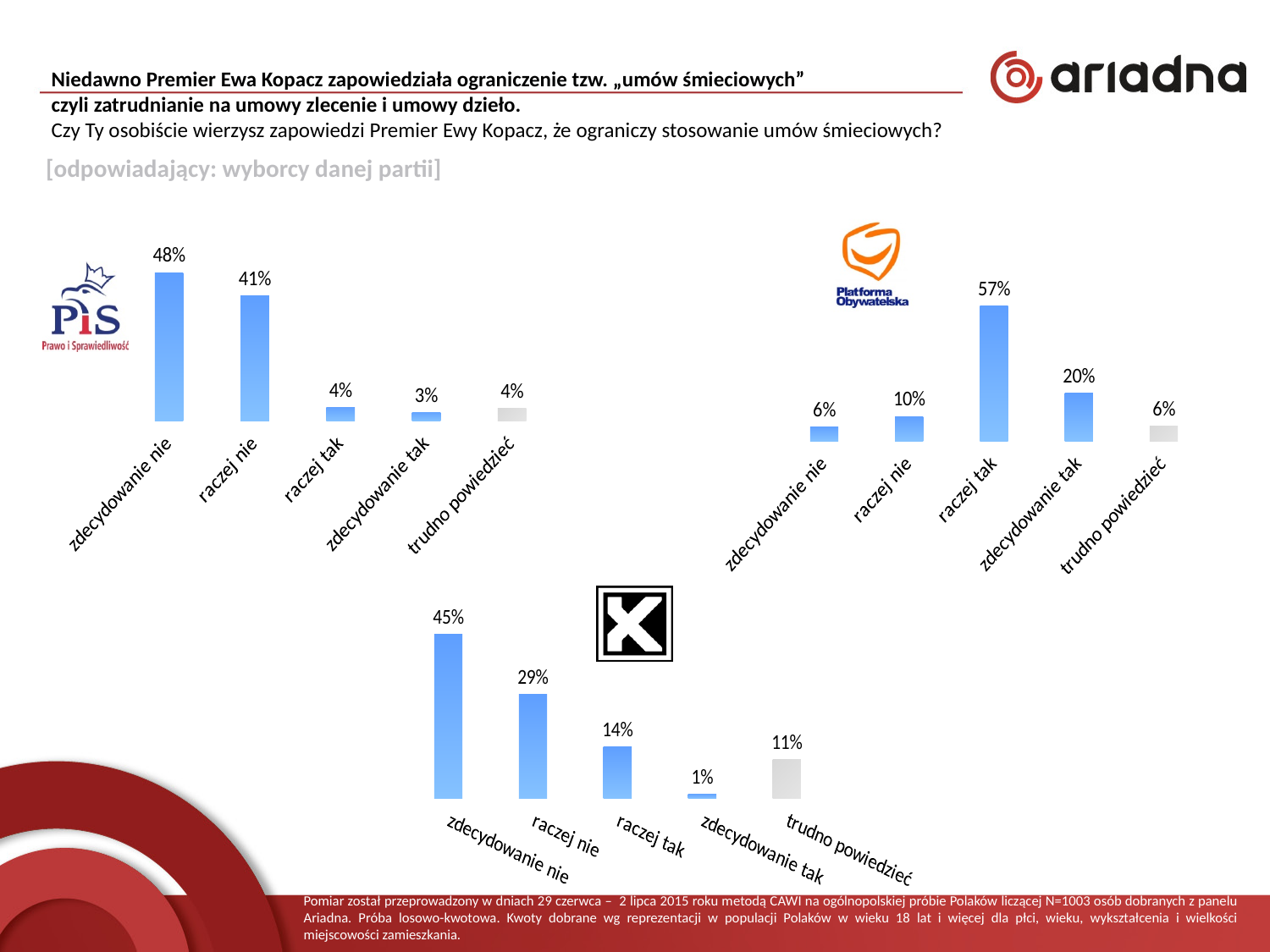
In the Platforma Obywatelska chart (top right), what is the difference between "raczej tak" and "zdecydowanie tak"? 37% In the bottom chart, what percentage answered "trudno powiedzieć"? 11% What type of chart is used for the Platforma Obywatelska data (top right)? bar chart In the bottom chart, which answer has the lowest value? zdecydowanie tak How many answer categories does the PiS chart (top left) show? 5 In the Platforma Obywatelska chart (top right), what percentage answered "raczej tak"? 57% In the Platforma Obywatelska chart (top right), which answer has the highest value? raczej tak In the bottom chart, which is larger: "raczej nie" or "raczej tak"? raczej nie In the PiS chart (top left), what percentage answered "zdecydowanie tak"? 3% In the PiS chart (top left), what is the difference between "zdecydowanie nie" and "raczej nie"? 7% In the PiS chart (top left), what percentage answered "zdecydowanie nie"? 48% In the bottom chart, what percentage answered "zdecydowanie tak"? 1%